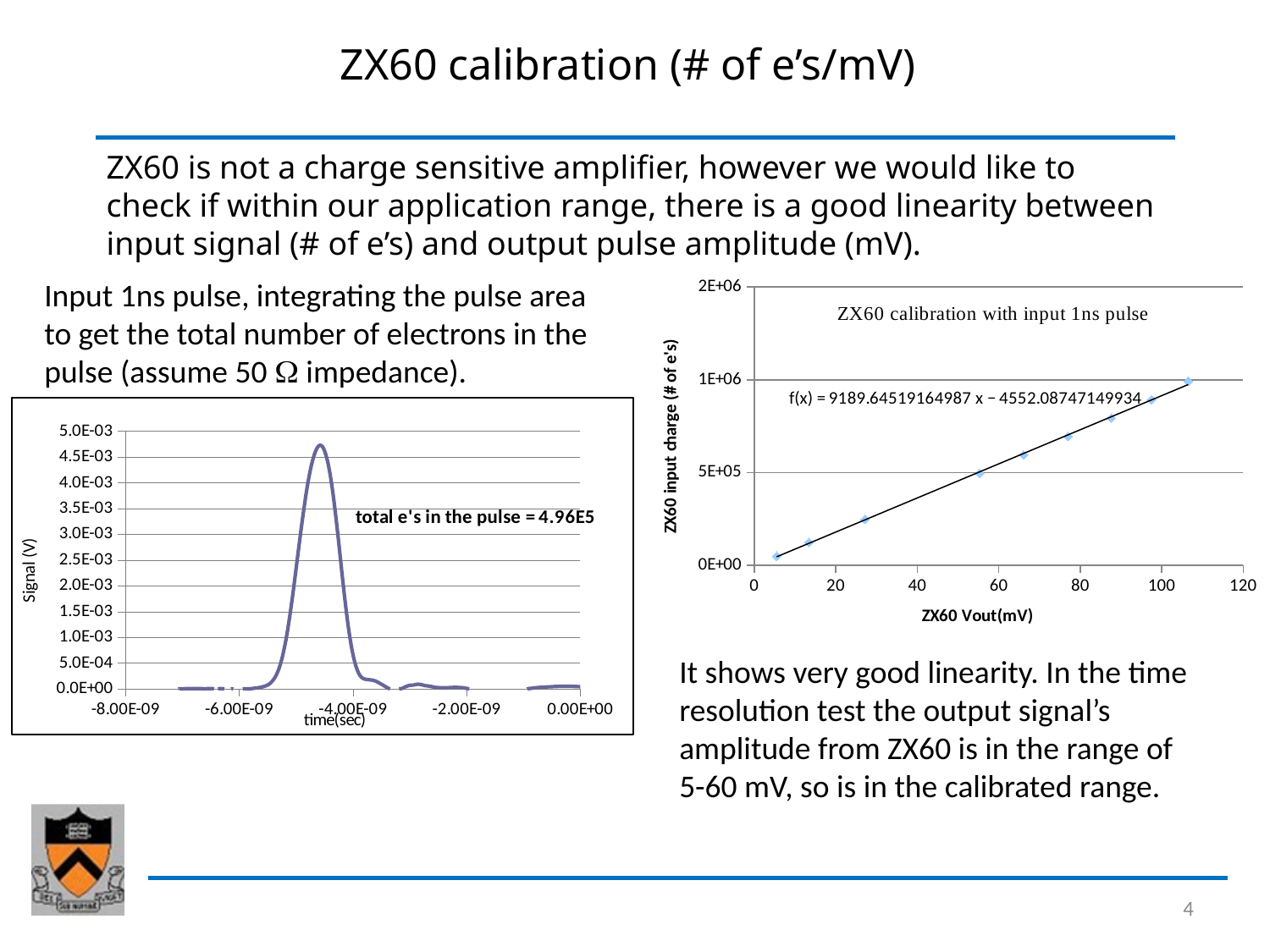
In the chart on the right, what is the label of the x axis? ZX60 Vout(mV) In the chart on the right, is the input charge for the point near 27 mV greater or less than 5E+05? less In the chart on the left, is the peak signal value greater or less than 4.0E-03? greater What kind of chart is the chart on the right of the slide? scatter chart What is the title of the chart on the right of the slide? ZX60 calibration with input 1ns pulse In the chart on the right, is the input charge for the point near 87 mV greater or less than 5E+05? greater In the chart on the right, what is the trendline equation shown? f(x) = 9189.64519164987 x − 4552.08747149934 In the chart on the left, is the peak of the pulse located before or after -6.00E-09 seconds on the time axis? after In the chart on the left, what total number of electrons in the pulse is stated in the annotation? 4.96E5 In the chart on the right, do the plotted values rise or fall as ZX60 Vout increases? rise What kind of chart is the chart on the left of the slide? line chart